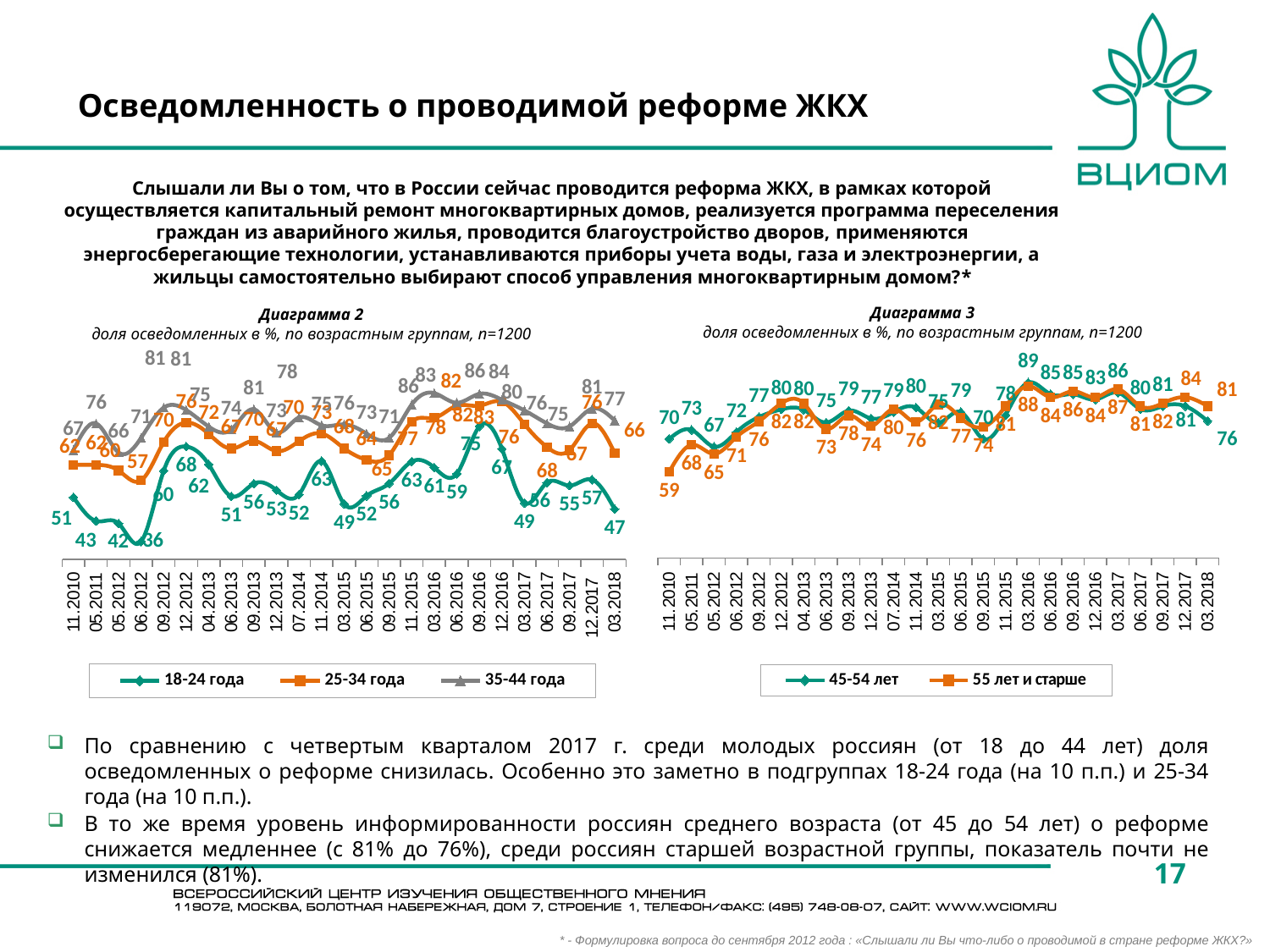
In Диаграмма 2, what is the value for 18-24 года at 03.2018? 47 In Диаграмма 3, what is the difference between 55 лет и старше and 45-54 лет at 03.2018? 5 In Диаграмма 2, what is the value for 18-24 года at 11.2010? 51 In Диаграмма 3, what is the value for 55 лет и старше at 11.2010? 59 In Диаграмма 2, what is the lowest value shown for 18-24 года? 36 What kind of chart is Диаграмма 2? Line chart How many series does the legend of Диаграмма 3 list? 2 In Диаграмма 3, what is the value for 55 лет и старше at 03.2018? 81 In Диаграмма 3, what is the value for 45-54 лет at 03.2018? 76 In Диаграмма 3, what is the highest value shown for 45-54 лет? 89 In Диаграмма 2, which is larger at 03.2018: 18-24 года or 25-34 года? 25-34 года How many series does the legend of Диаграмма 2 list? 3